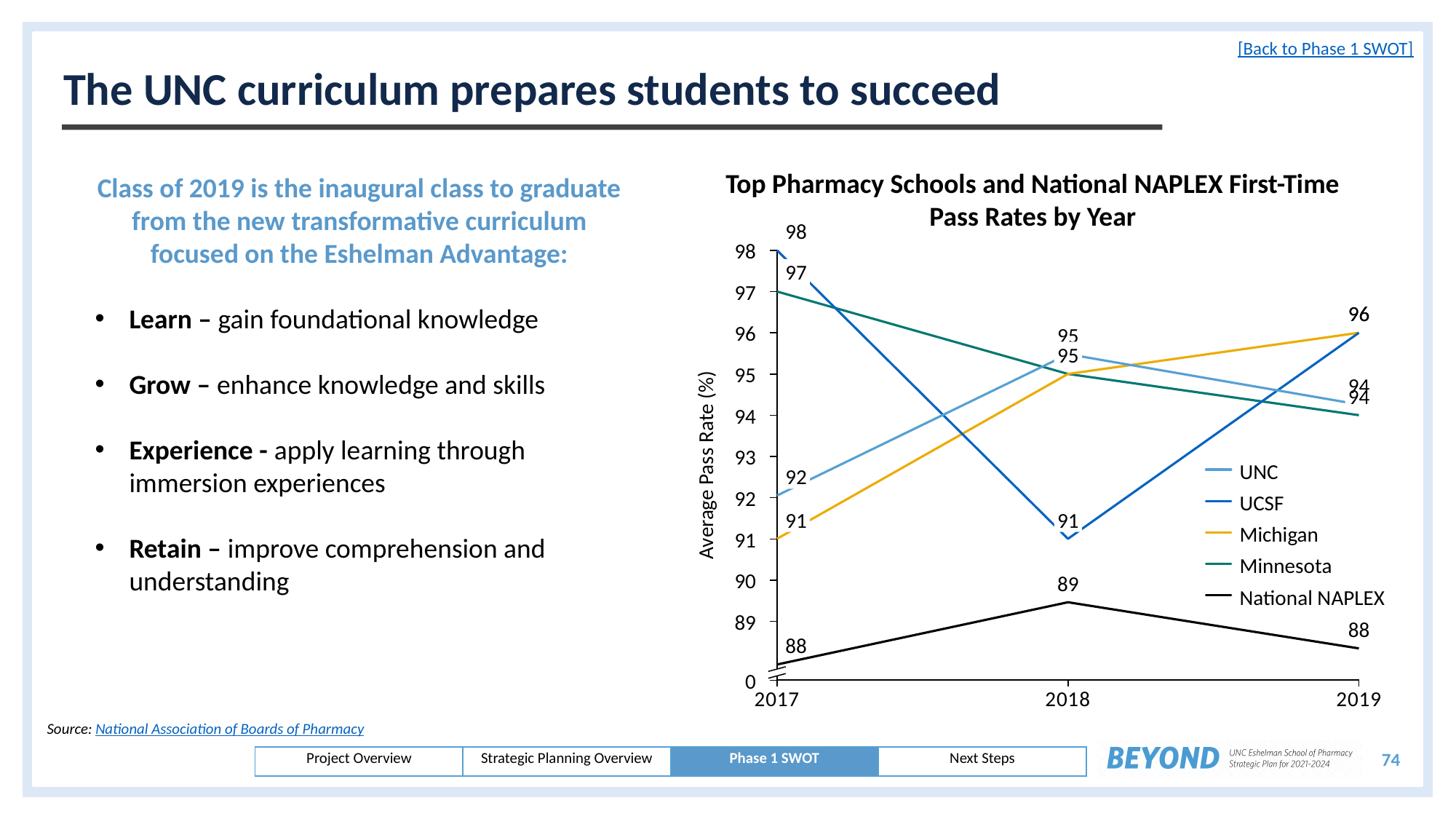
Which series had the highest pass rate in 2017? UCSF What was UCSF's first-time pass rate in 2017? 98 How many years are shown on the x axis of the chart? 3 Does Minnesota's pass rate rise or fall from 2017 to 2019? Fall By how many points did UCSF's pass rate drop from 2017 to 2018? 7 What was the National NAPLEX first-time pass rate in 2018? 89 What was UNC's first-time pass rate in 2017? 92 What was UCSF's first-time pass rate in 2018? 91 Which series had the lowest pass rate in 2017? National NAPLEX What was Michigan's first-time pass rate in 2017? 91 How many series does the legend of the chart list? 5 What kind of chart is shown on the slide? Line chart